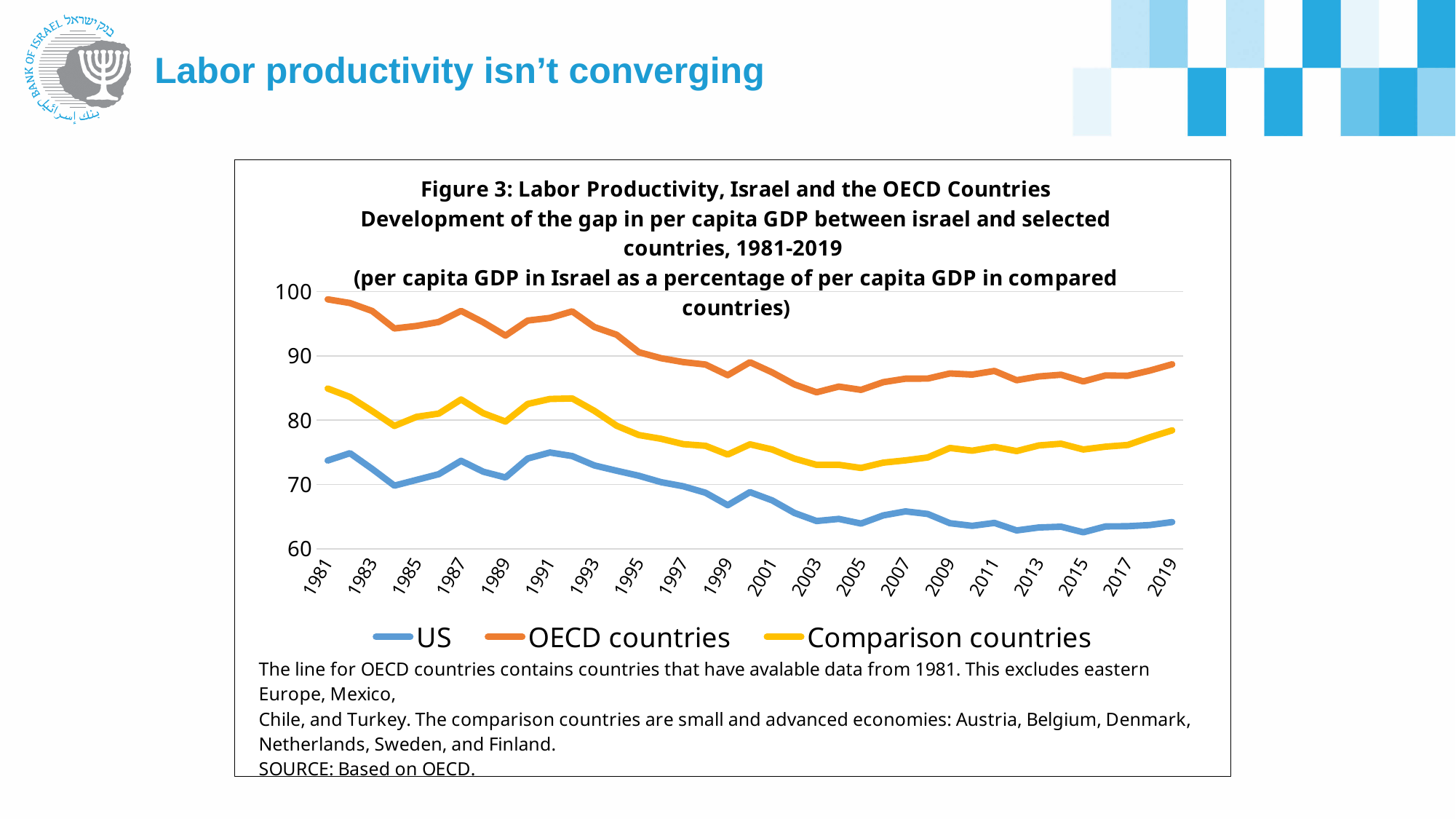
Is the value for the US in 2015 greater or less than 70? less Is the value for the US in 1981 greater or less than 70? greater What is the first year shown on the x axis? 1981 What kind of chart is shown on the slide? line chart What colour is the line for Comparison countries? yellow Is the value for OECD countries in 2003 greater or less than 90? less How many series does the legend list? 3 In 2019, which is larger: the value for OECD countries or the value for the US? OECD countries Which series has the lowest values across the whole period? US Does the US line rise or fall overall from 1981 to 2019? fall Which series has the highest values across the whole period? OECD countries